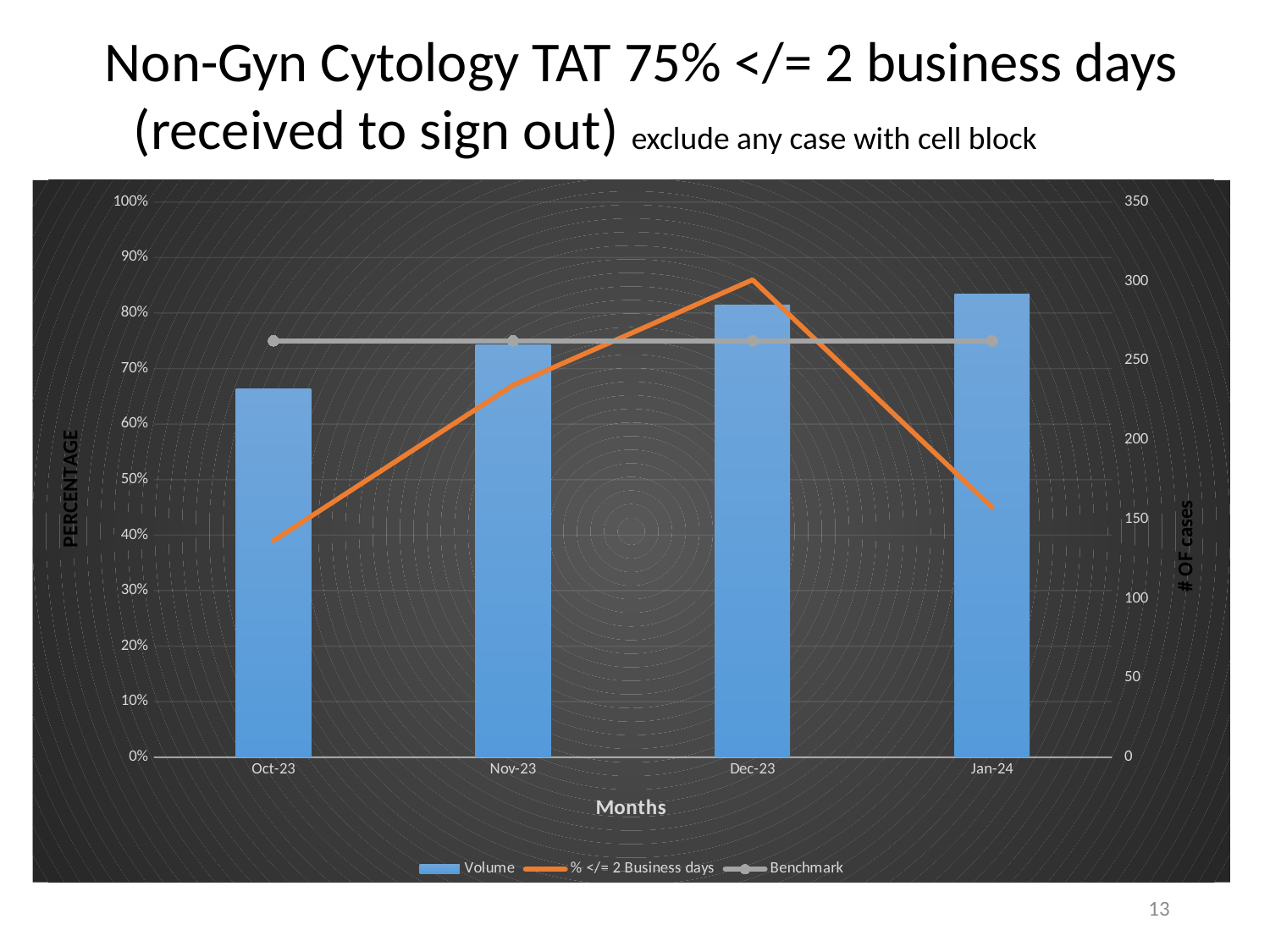
Is the Volume for Dec-23 greater or less than 250 cases? greater Which month has the lowest value for the % </= 2 Business days line? Oct-23 Is the Volume for Oct-23 greater or less than 250 cases? less How many months are shown on the x axis of the chart? 4 What is the label of the x axis of the chart? Months Is the % </= 2 Business days value for Jan-24 greater or less than 50%? less Which month has the lowest Volume bar? Oct-23 What kind of chart is shown on the slide? A combination bar and line chart How many series does the chart legend list? 3 Which month has the highest value for the % </= 2 Business days line? Dec-23 Is the Volume for Nov-23 larger or smaller than the Volume for Oct-23? larger